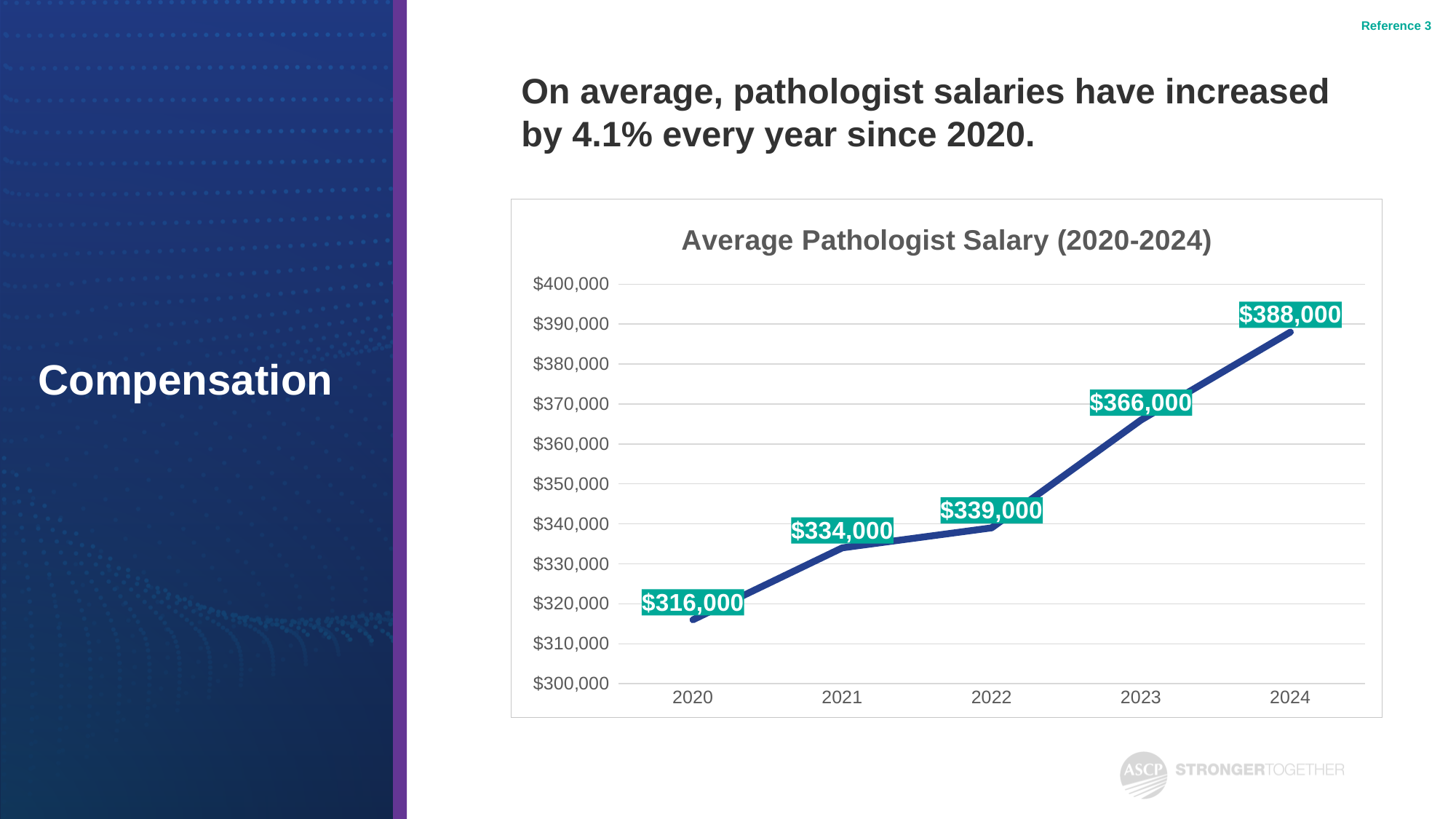
Is the average salary for 2023 greater or less than $360,000? greater What is the difference between the average salary in 2024 and in 2020? $72,000 What is the difference between the average salary in 2023 and in 2022? $27,000 Which year has the lowest average pathologist salary? 2020 What kind of chart is shown on the slide? Line chart How many years are plotted on the chart? 5 Do the average salary values rise or fall from 2020 to 2024? Rise What is the average pathologist salary shown for 2022? $339,000 Which year has the highest average pathologist salary? 2024 Which year has a higher average salary, 2021 or 2023? 2023 What is the average pathologist salary shown for 2024? $388,000 What is the average pathologist salary shown for 2020? $316,000